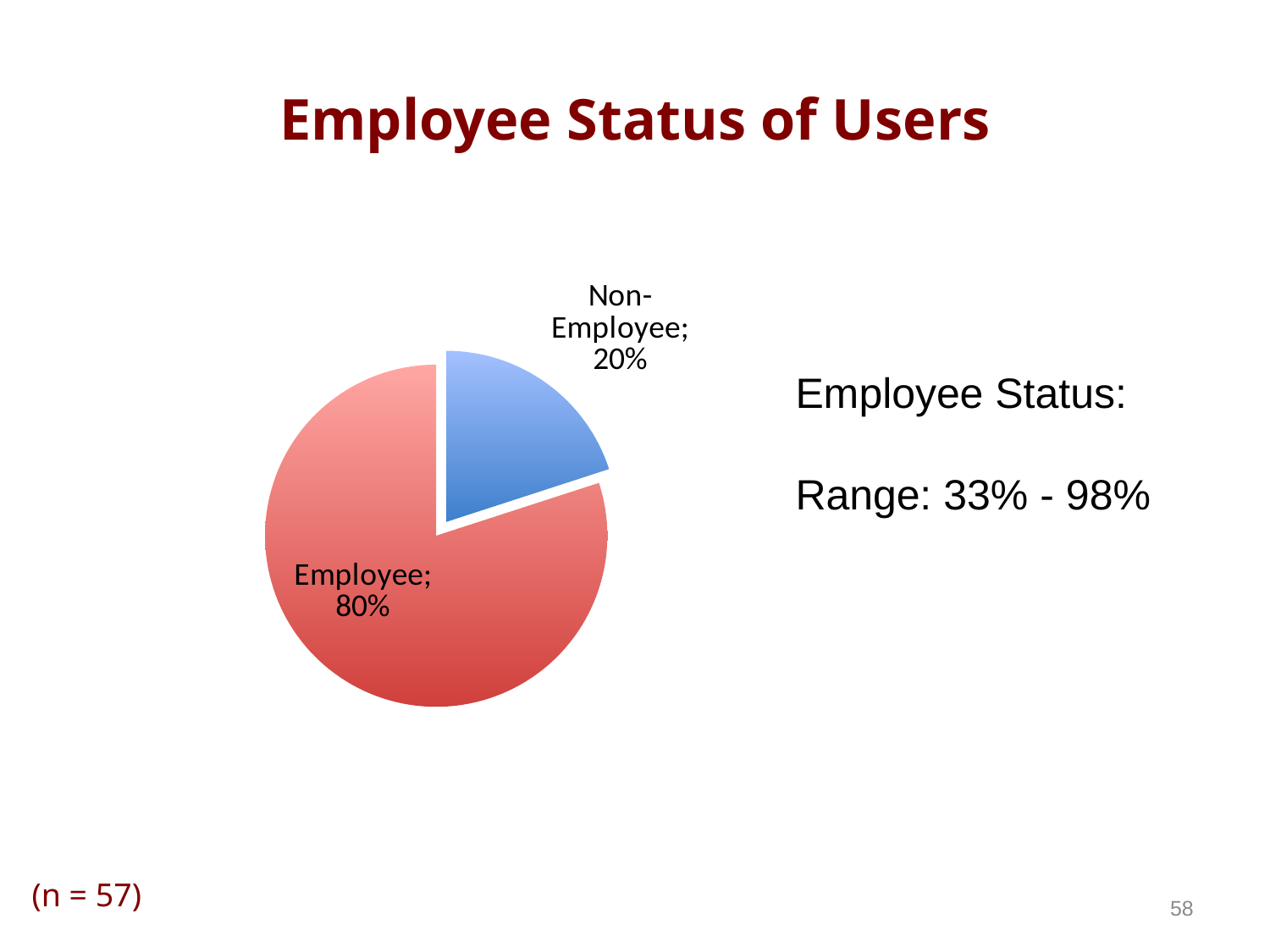
Which category has the smallest slice of the pie? Non-Employee What share of users are Non-Employees? 20% Which category has the largest slice of the pie? Employee What is the title of the slide containing the pie chart? Employee Status of Users What is the difference in percentage points between the Employee and Non-Employee slices? 60 Which slice is larger, Employee or Non-Employee? Employee What is the sample size (n) shown on the slide? 57 What kind of chart is shown on the slide? pie chart How many slices does the pie chart have? 2 What share of users are Employees? 80% What range is given for Employee Status on the slide? 33% - 98% What colour is the Non-Employee slice? blue